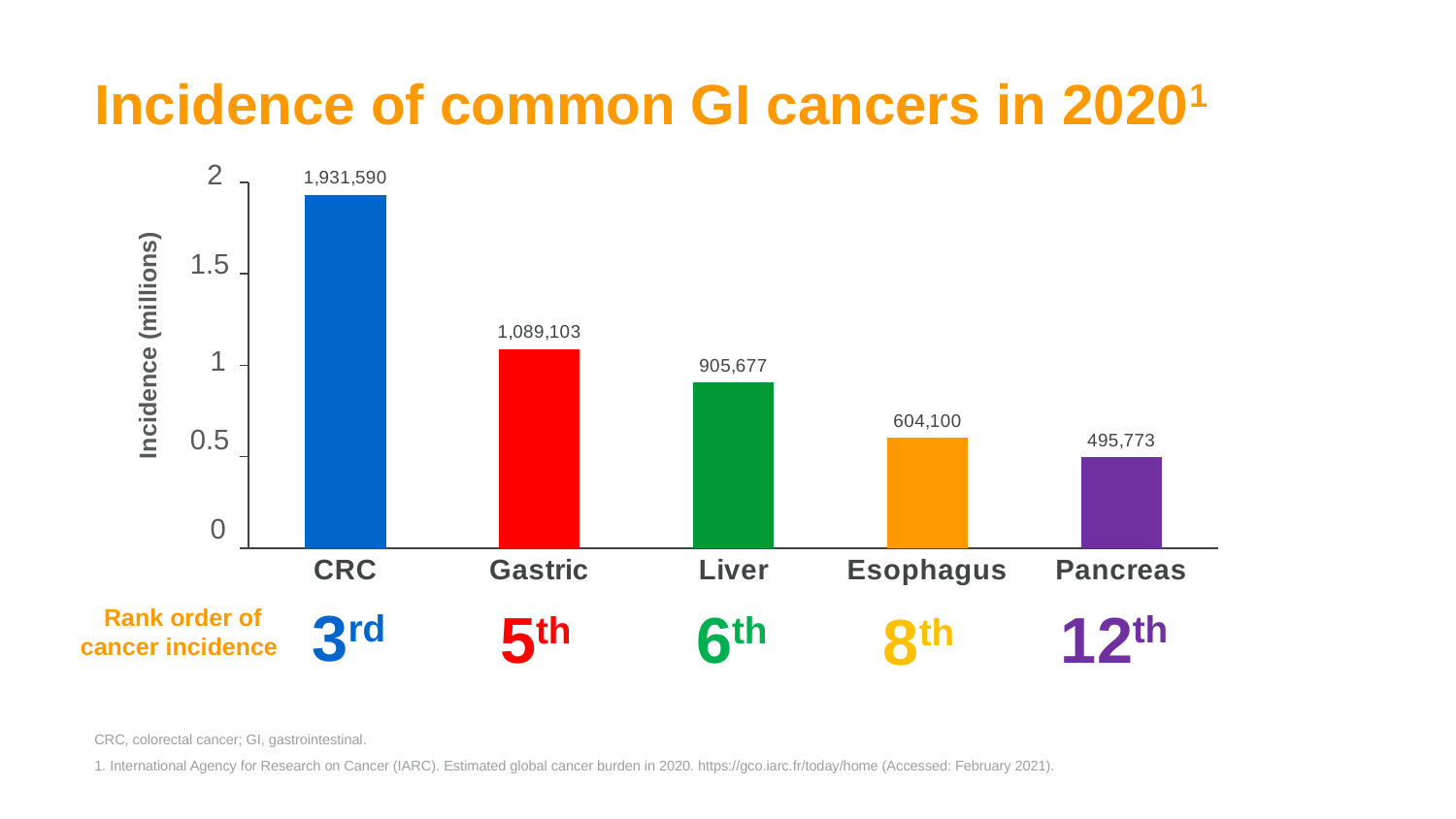
How many cancer types are shown in the chart? 5 What is the incidence value shown for CRC? 1,931,590 Is the value for Esophagus greater or less than 0.5 million? greater What is the difference between the incidence values for Esophagus and Pancreas? 108,327 What is the incidence value shown for Liver? 905,677 Which cancer type has the lowest incidence in the chart? Pancreas What is the incidence value shown for Pancreas? 495,773 Which cancer type has the highest incidence in the chart? CRC What kind of chart is shown on the slide? Bar chart What is the difference between the incidence values for CRC and Gastric? 842,487 What is the label of the vertical axis? Incidence (millions) Which has a higher incidence, Gastric or Liver? Gastric